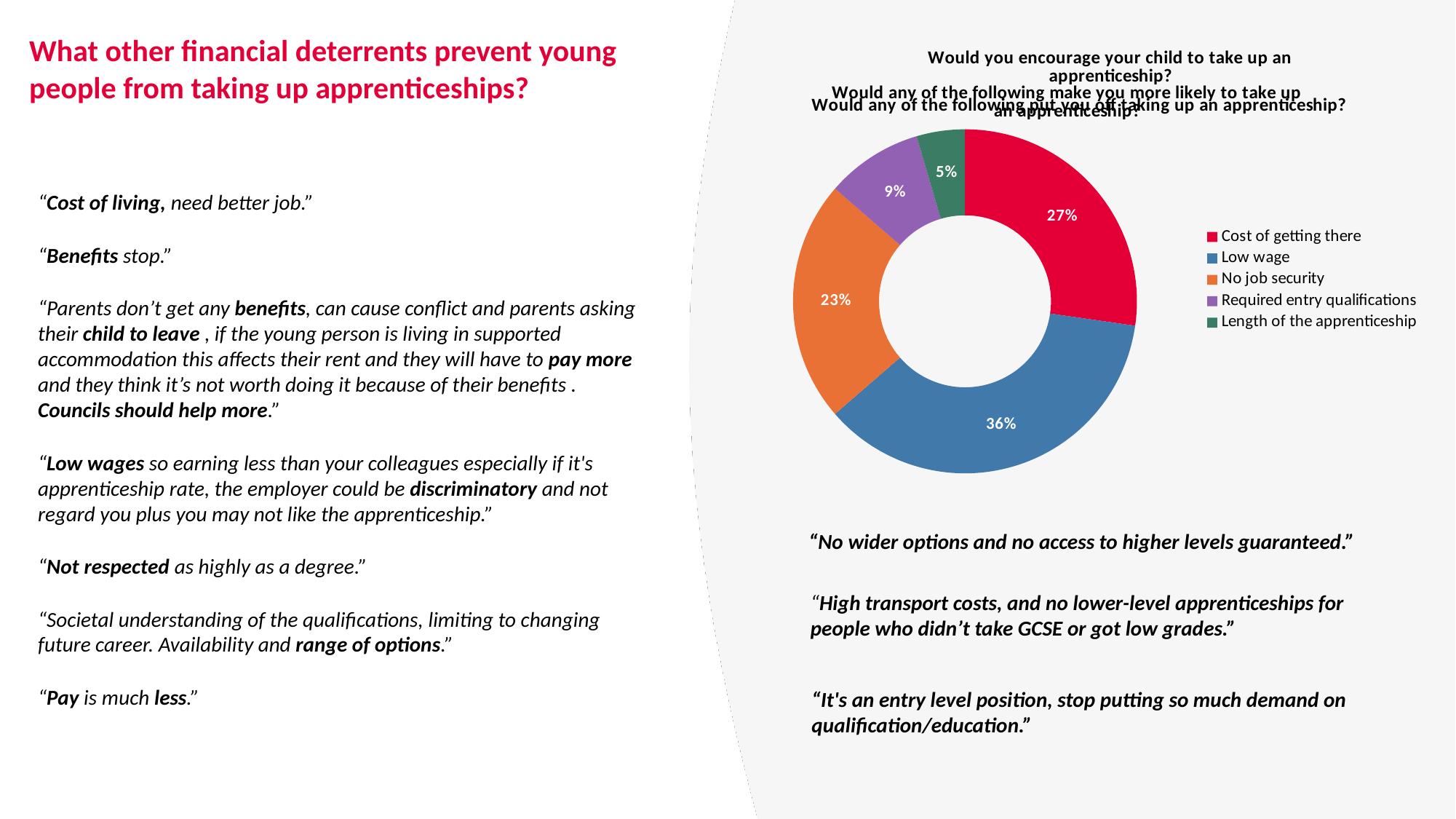
What colour is the Low wage segment in the doughnut chart? Blue Which is larger, the share for No job security or the share for Required entry qualifications? No job security Which category has the smallest share of the doughnut chart? Length of the apprenticeship Which category has the largest share of the doughnut chart? Low wage What percentage is shown for No job security? 23% What percentage is shown for Cost of getting there? 27% What percentage is shown for Length of the apprenticeship? 5% What kind of chart is shown on the slide? Doughnut chart What is the difference in percentage points between Low wage and Cost of getting there? 9 How many categories does the legend of the doughnut chart list? 5 What percentage is shown for Required entry qualifications? 9% What percentage of the doughnut chart is labelled for Low wage? 36%